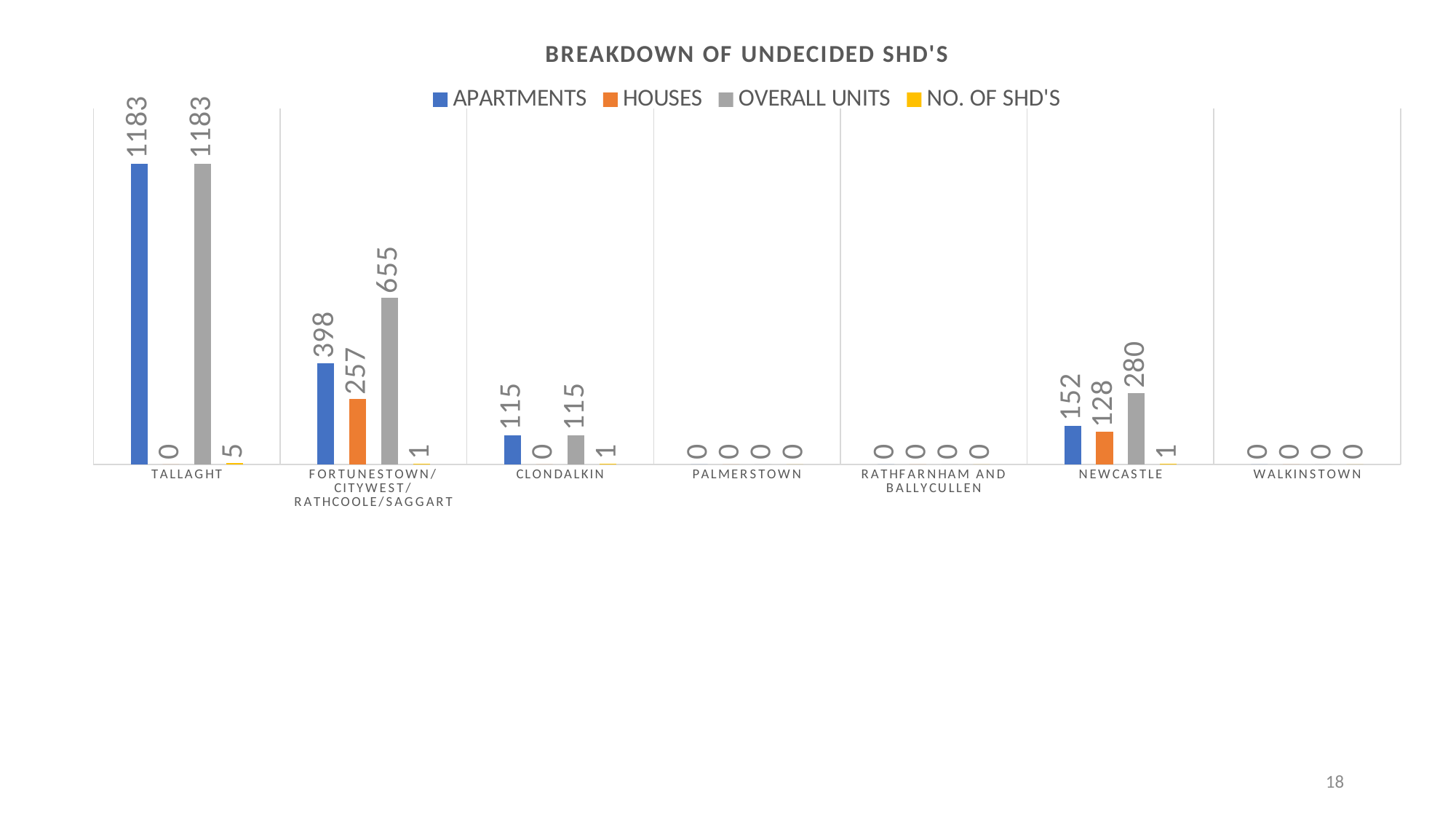
Which category has the highest value for OVERALL UNITS? TALLAGHT What is the value for APARTMENTS in TALLAGHT? 1183 What is the value for HOUSES in FORTUNESTOWN/CITYWEST/RATHCOOLE/SAGGART? 257 What kind of chart is this? Bar chart What is the value for OVERALL UNITS in NEWCASTLE? 280 How many series does the legend list? 4 What is the value for APARTMENTS in CLONDALKIN? 115 What is the value for NO. OF SHD'S in TALLAGHT? 5 How many categories are shown on the x axis? 7 Which is larger: APARTMENTS in NEWCASTLE or HOUSES in NEWCASTLE? APARTMENTS in NEWCASTLE What is the difference between OVERALL UNITS in TALLAGHT and OVERALL UNITS in FORTUNESTOWN/CITYWEST/RATHCOOLE/SAGGART? 528 What is the title of the chart? BREAKDOWN OF UNDECIDED SHD'S